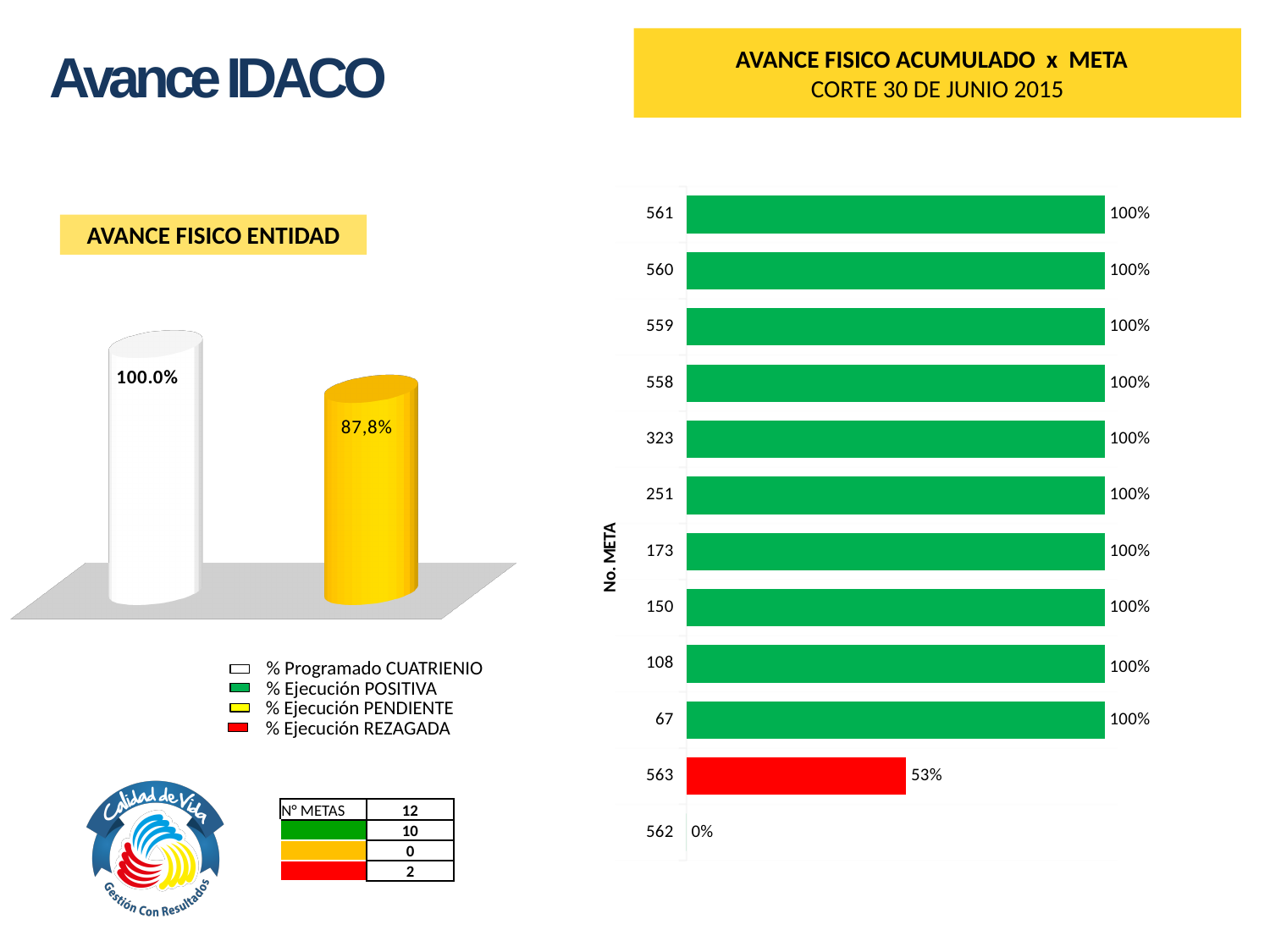
In the AVANCE FISICO ACUMULADO x META chart, how many metas are plotted? 12 In the AVANCE FISICO ENTIDAD chart, what is the value of the yellow bar? 87,8% In the AVANCE FISICO ACUMULADO x META chart, what is the difference between the values for meta 67 and meta 563? 47% In the AVANCE FISICO ACUMULADO x META chart, which is larger, the value for meta 563 or the value for meta 562? 563 How many series does the legend of the AVANCE FISICO ENTIDAD chart list? 4 In the AVANCE FISICO ACUMULADO x META chart, what is the value for meta 562? 0% In the AVANCE FISICO ENTIDAD chart, what is the value of the % Programado CUATRIENIO bar? 100.0% In the AVANCE FISICO ACUMULADO x META chart, what is the value for meta 563? 53% What kind of chart is the AVANCE FISICO ACUMULADO x META chart? bar chart In the AVANCE FISICO ACUMULADO x META chart, which meta has the lowest value? 562 In the AVANCE FISICO ACUMULADO x META chart, what is the label of the vertical axis? No. META In the AVANCE FISICO ACUMULADO x META chart, what is the value for meta 323? 100%